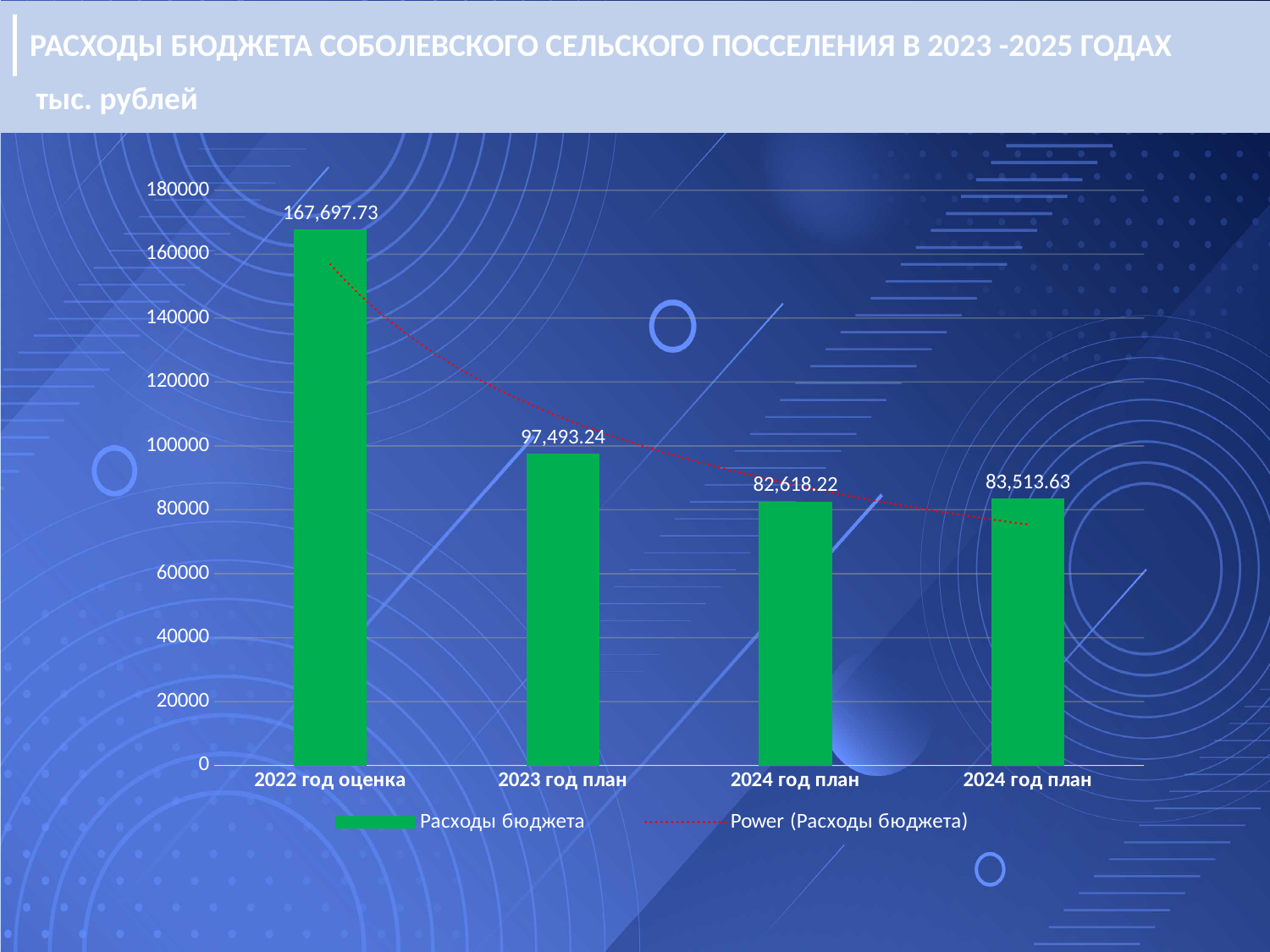
Which is larger, the value for 2022 год оценка or for 2023 год план? 2022 год оценка What is the difference between the rightmost bar and the third bar from the left? 895.41 What is the lowest value shown on the chart? 82,618.22 What is the value shown on the third bar from the left? 82,618.22 How many entries does the legend list? 2 What is the value for 2022 год оценка? 167,697.73 How many bars are shown on the chart? 4 What is the difference between the values for 2022 год оценка and 2023 год план? 70,204.49 What is the value shown on the rightmost bar? 83,513.63 What is the value for 2023 год план? 97,493.24 Which category has the highest value? 2022 год оценка What kind of chart is shown on the slide? bar chart